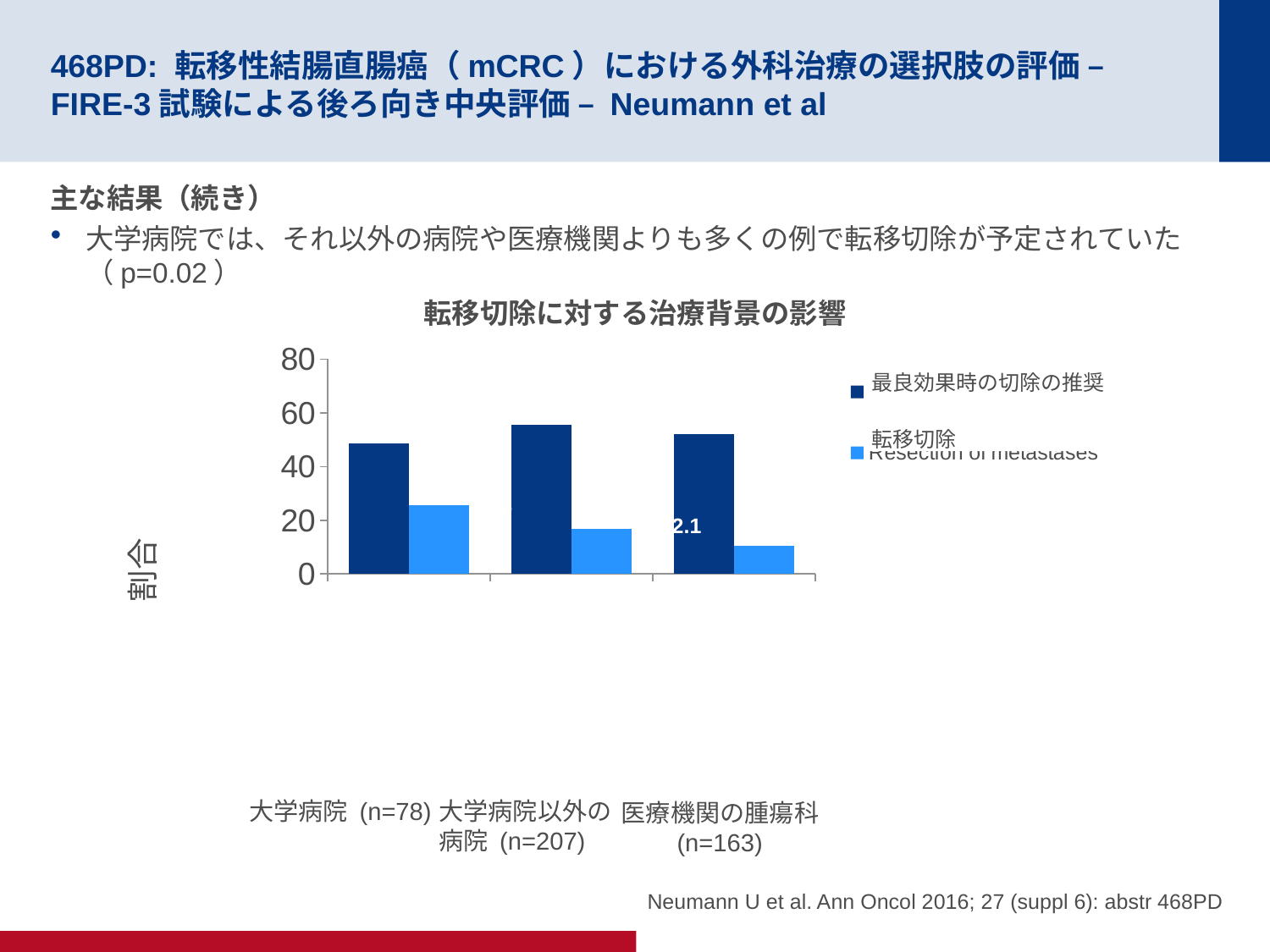
Is the value for 転移切除 at 医療機関の腫瘍科 (n=163) greater or less than 20? less Is the value for 転移切除 at 大学病院 (n=78) greater or less than 20? greater What kind of chart is shown on the slide? bar chart Which category has the highest value for 転移切除? 大学病院 (n=78) Which category has the lowest value for 転移切除? 医療機関の腫瘍科 (n=163) Is the value for 最良効果時の切除の推奨 at 大学病院 (n=78) greater or less than 60? less Do the values for 転移切除 rise or fall from left to right across the categories? fall Which category has the highest value for 最良効果時の切除の推奨? 大学病院以外の病院 (n=207) How many categories are shown on the x axis of the chart? 3 What is the title of the chart? 転移切除に対する治療背景の影響 How many series does the chart's legend list? 2 What is the label on the vertical axis of the chart? 割合